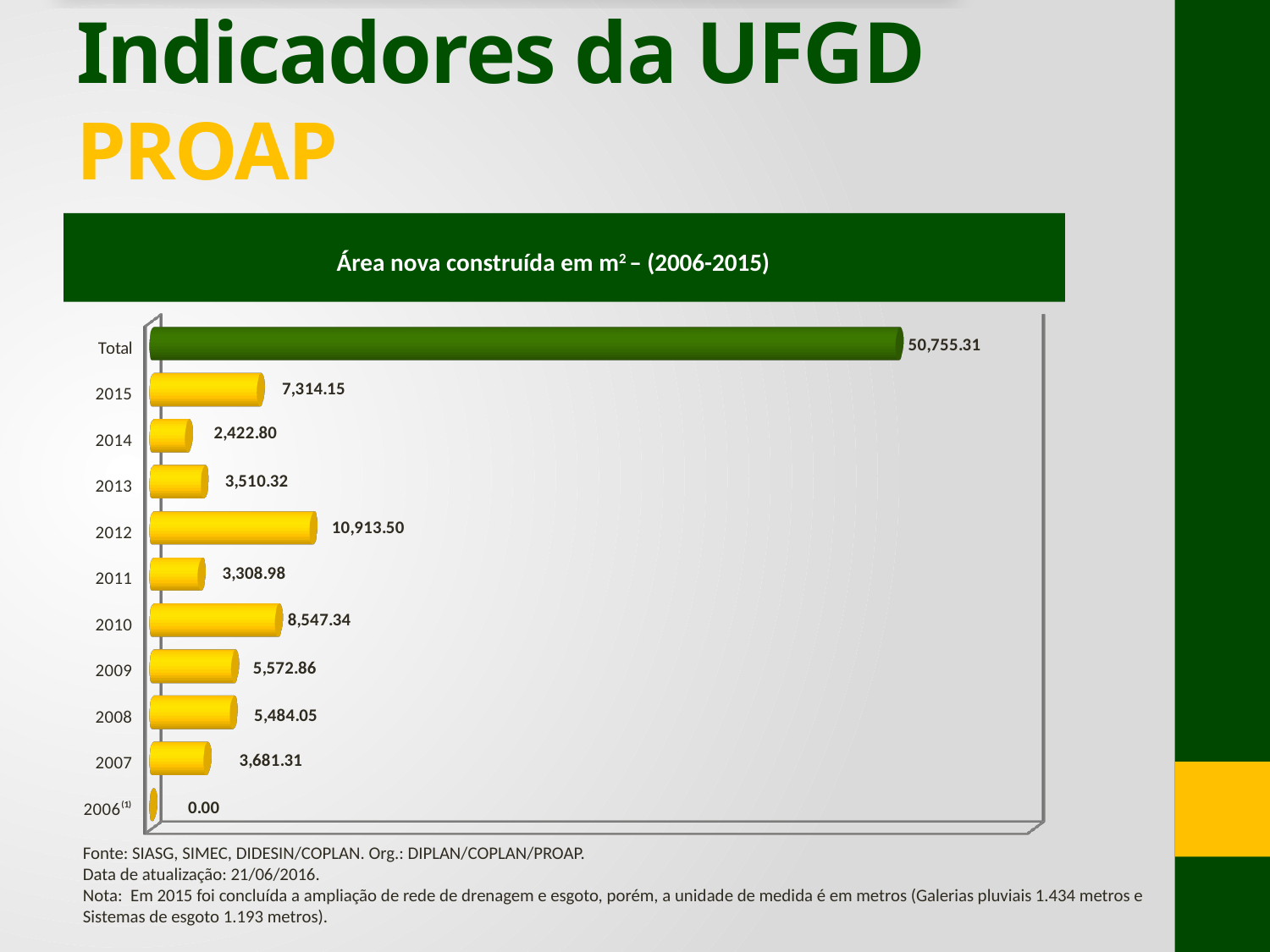
How many years (excluding the Total bar) are shown in the chart? 10 What is the value for 2012 in the chart? 10,913.50 Which year has the lowest value in the chart? 2006 Which year has the highest value in the chart? 2012 What is the difference between the values for 2015 and 2014? 4,891.35 Which is larger, the value for 2013 or the value for 2011? 2013 What is the value for 2014? 2,422.80 What is the title of the chart? Área nova construída em m² – (2006-2015) What is the difference between the values for 2010 and 2009? 2,974.48 What kind of chart is shown on the slide? Bar chart Do the values rise or fall from 2006 to 2008? Rise What is the value shown for the Total bar? 50,755.31